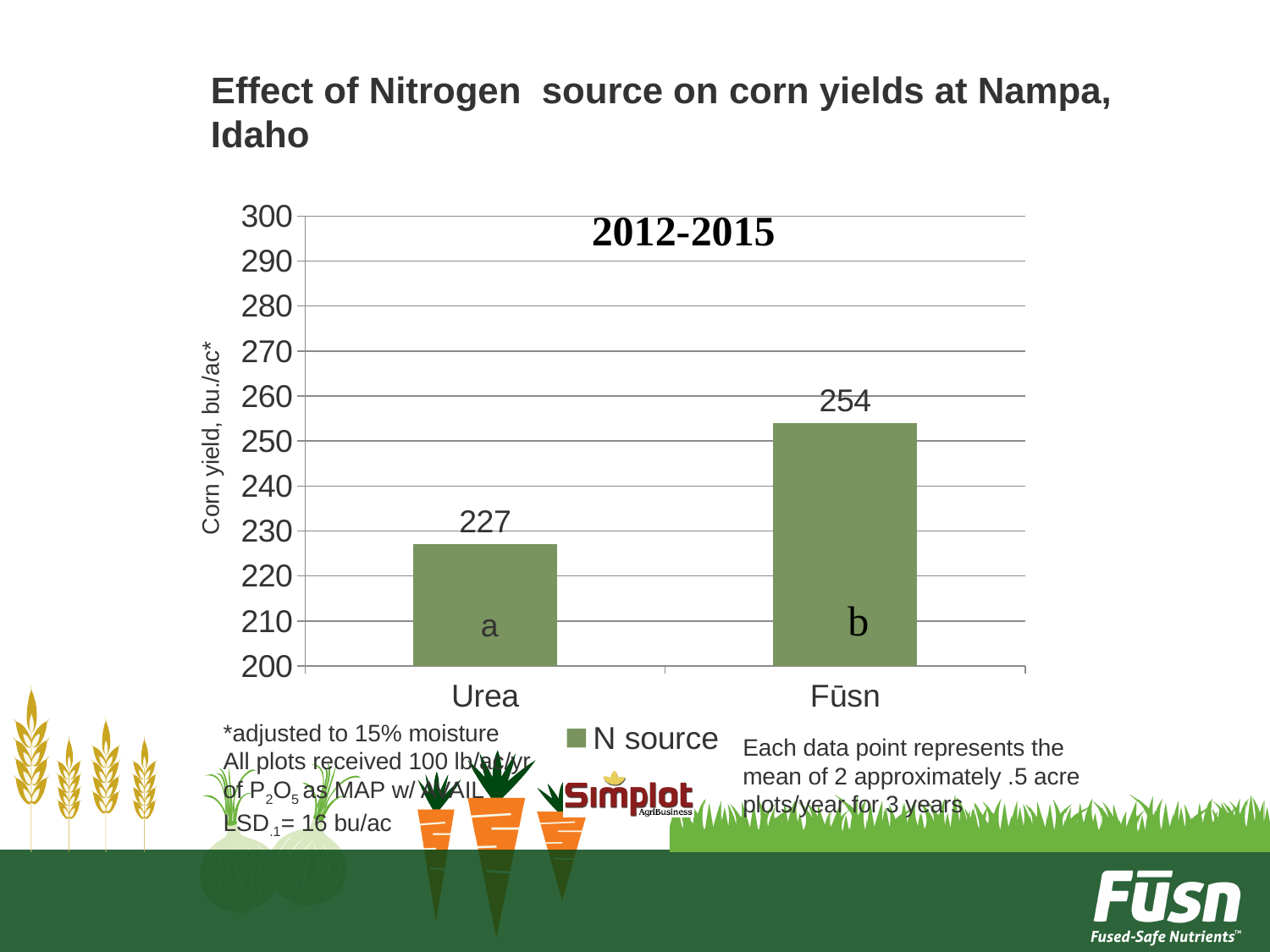
What is the title shown inside the chart area? 2012-2015 Is the corn yield for Fūsn greater or less than 250? greater Which has a larger corn yield, Urea or Fūsn? Fūsn What kind of chart is shown on the slide? bar chart How many nitrogen sources are shown in the chart? 2 Which nitrogen source has the highest corn yield? Fūsn What is the difference in corn yield between Fūsn and Urea? 27 Which nitrogen source has the lowest corn yield? Urea What is the corn yield for Fūsn? 254 What is the corn yield for Urea? 227 How many series does the legend list? 1 Is the corn yield for Urea greater or less than 230? less